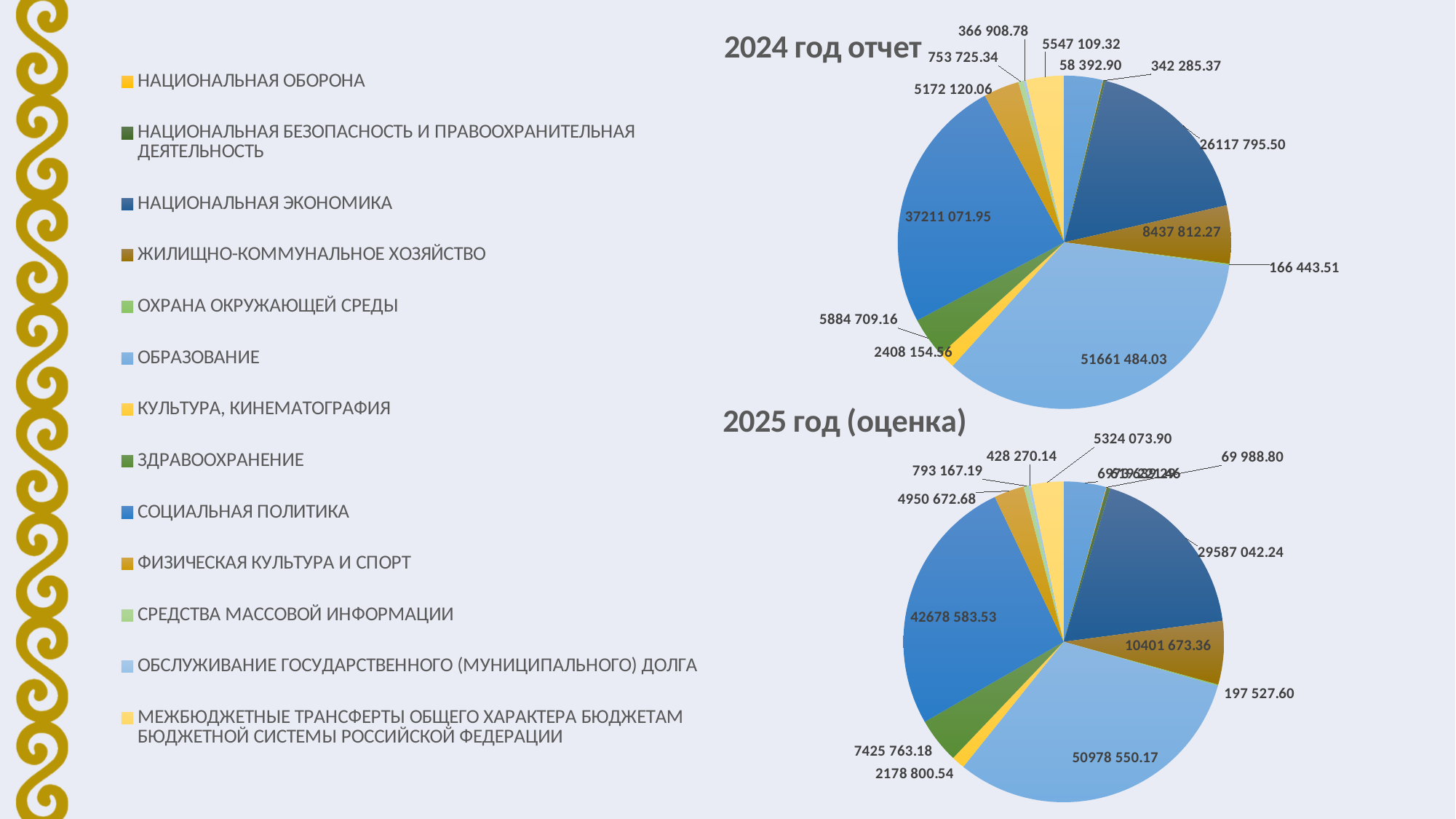
How many categories does the legend list? 13 In the "2025 год (оценка)" pie chart, what is the value for СОЦИАЛЬНАЯ ПОЛИТИКА? 42678 583.53 What kind of charts are shown on the slide? Pie charts In the "2024 год отчет" pie chart, which is larger: ЗДРАВООХРАНЕНИЕ or ФИЗИЧЕСКАЯ КУЛЬТУРА И СПОРТ? ЗДРАВООХРАНЕНИЕ In the "2025 год (оценка)" pie chart, what is the value for НАЦИОНАЛЬНАЯ ЭКОНОМИКА? 29587 042.24 In the "2024 год отчет" pie chart, what is the value for ЖИЛИЩНО-КОММУНАЛЬНОЕ ХОЗЯЙСТВО? 8437 812.27 In the "2025 год (оценка)" pie chart, what is the difference between the values for СОЦИАЛЬНАЯ ПОЛИТИКА and НАЦИОНАЛЬНАЯ ЭКОНОМИКА? 13091 541.29 In the "2024 год отчет" pie chart, which category has the largest slice? ОБРАЗОВАНИЕ In the "2024 год отчет" pie chart, what is the value for ОБРАЗОВАНИЕ? 51661 484.03 In the "2024 год отчет" pie chart, what is the difference between the values for ОБРАЗОВАНИЕ and СОЦИАЛЬНАЯ ПОЛИТИКА? 14450 412.08 What is the title of the lower chart on the slide? 2025 год (оценка) In the "2025 год (оценка)" pie chart, which category has the largest slice? ОБРАЗОВАНИЕ